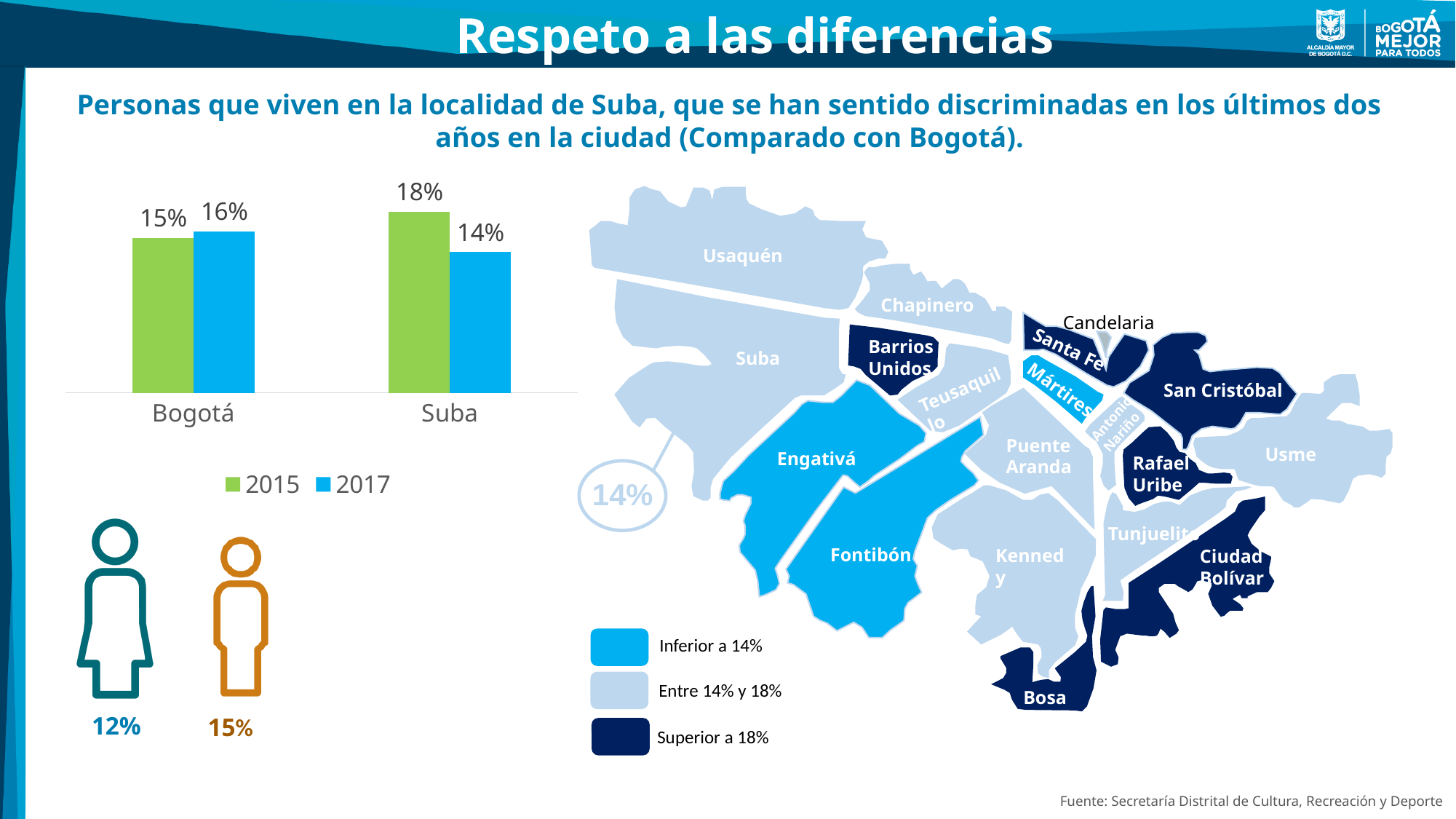
In the bar chart, what is the value for Suba in 2017? 14% In the bar chart, what is the value for Bogotá in 2015? 15% In the bar chart, what is the value for Suba in 2015? 18% How many categories are shown on the x axis of the bar chart? 2 In the bar chart, which is larger for Bogotá: the 2015 value or the 2017 value? 2017 In the bar chart, which category has the lowest value in the 2017 series? Suba How many series does the legend of the bar chart list? 2 In the bar chart, what is the value for Bogotá in 2017? 16% In the bar chart, did the value for Suba rise or fall from 2015 to 2017? fall In the bar chart, which category has the highest value in the 2015 series? Suba What kind of chart is shown on the left of the slide? bar chart In the bar chart, what is the difference between Suba's 2015 value and its 2017 value? 4%